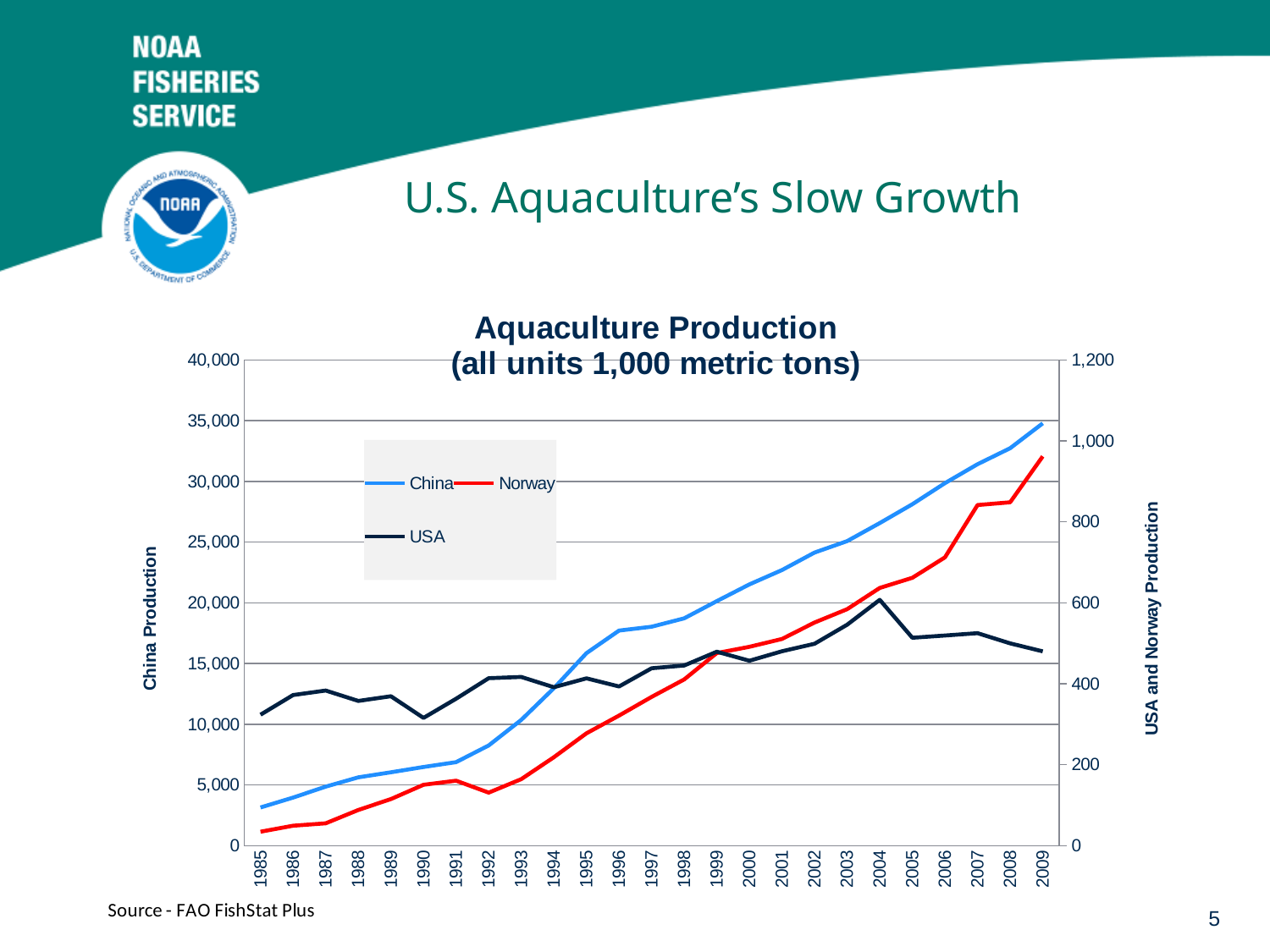
Is the value for China in 2009 greater or less than 30,000? greater Is the value for USA in 2009 greater or less than 600? less What kind of chart is shown on the slide? line chart Is the value for China in 1985 greater or less than 5,000? less Does China's aquaculture production rise or fall from 1985 to 2009? rise In 2009, which is larger, the value for USA or the value for Norway? Norway In which year does the USA series reach its highest value? 2004 What is the title of the right-hand vertical axis? USA and Norway Production How many series does the legend list? 3 How many years are plotted along the x axis? 25